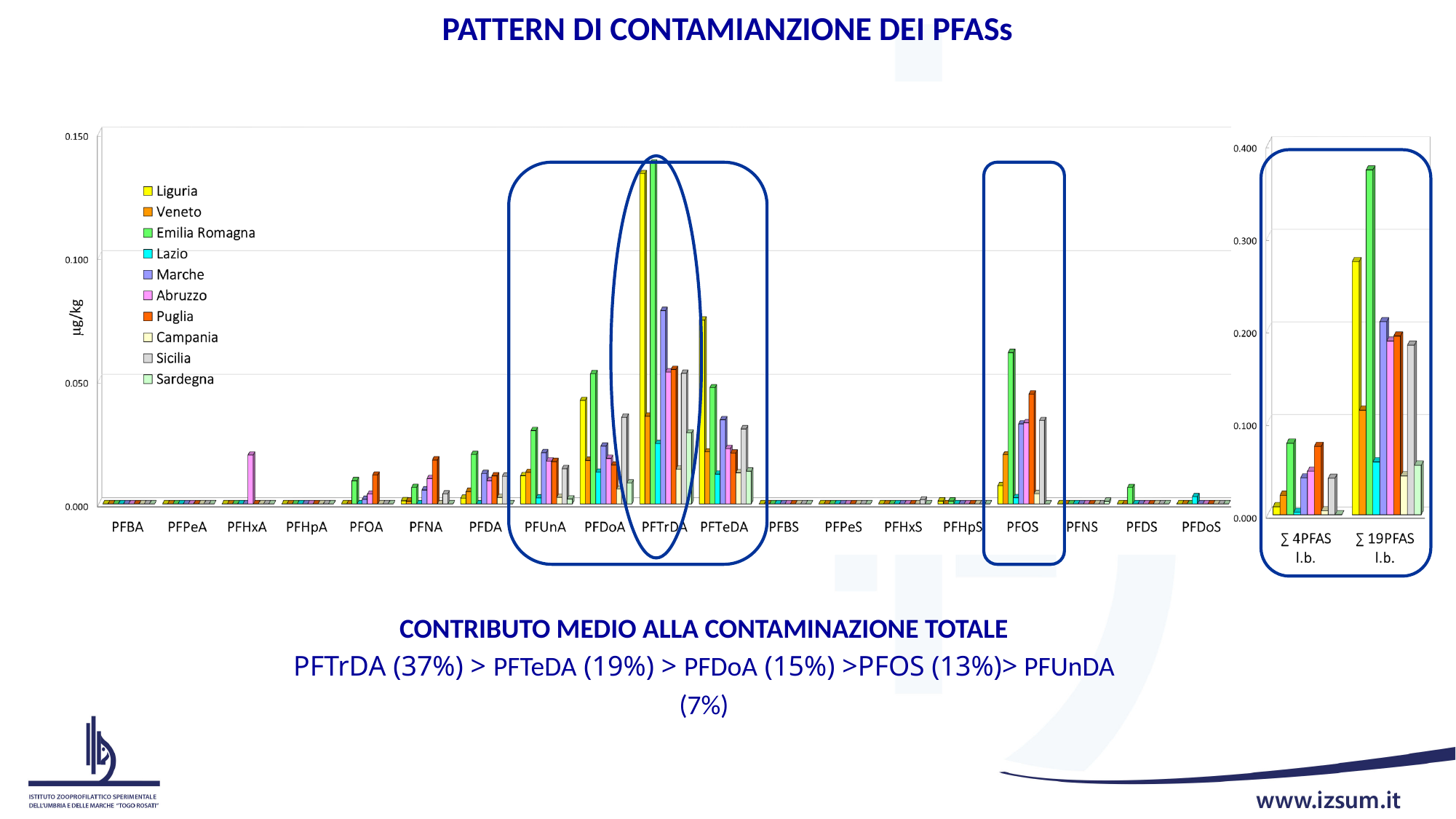
How many PFAS compound categories are shown on the x axis of the large chart? 19 In the small chart on the right, which region has the highest value for ∑ 19PFAS l.b.? Emilia Romagna In the small chart on the right, is the value for Emilia Romagna at ∑ 4PFAS l.b. greater or less than 0.100? less In the large chart, which region has the highest value for PFOS? Emilia Romagna In the small chart on the right, is the value for Emilia Romagna at ∑ 19PFAS l.b. greater or less than 0.300? greater How many series (regions) does the legend of the large chart list? 10 In the large chart, is the value for Emilia Romagna at PFOS greater or less than 0.100? less How many categories are shown on the x axis of the small chart on the right? 2 In the large chart, which is larger for PFOS: the value for Emilia Romagna or the value for Veneto? Emilia Romagna What unit is shown on the y axis of the large chart? µg/kg What kind of chart is the large chart on the left of the slide? bar chart